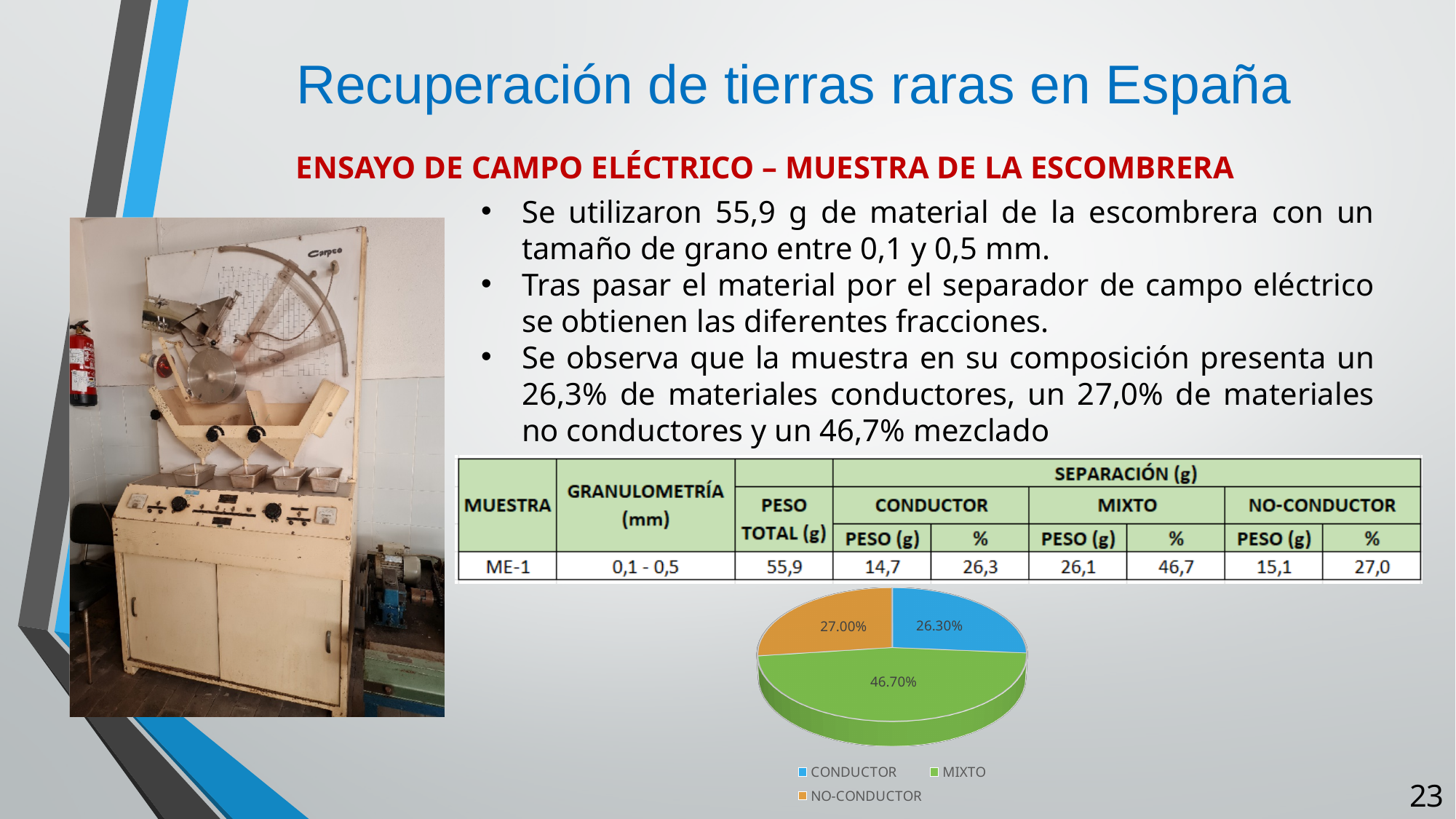
What colour is the CONDUCTOR slice in the pie chart? Blue How many slices does the pie chart have? 3 What is the value shown for the CONDUCTOR slice of the pie chart? 26.30% Which category has the smallest slice in the pie chart? CONDUCTOR What is the difference between the MIXTO and CONDUCTOR slices in the pie chart? 20.40% How many entries does the legend of the pie chart list? 3 What colour is the MIXTO slice in the pie chart? Green What kind of chart is shown on the slide? Pie chart What is the value shown for the MIXTO slice of the pie chart? 46.70% What is the value shown for the NO-CONDUCTOR slice of the pie chart? 27.00% Which category has the largest slice in the pie chart? MIXTO Which is larger in the pie chart, the NO-CONDUCTOR slice or the CONDUCTOR slice? NO-CONDUCTOR